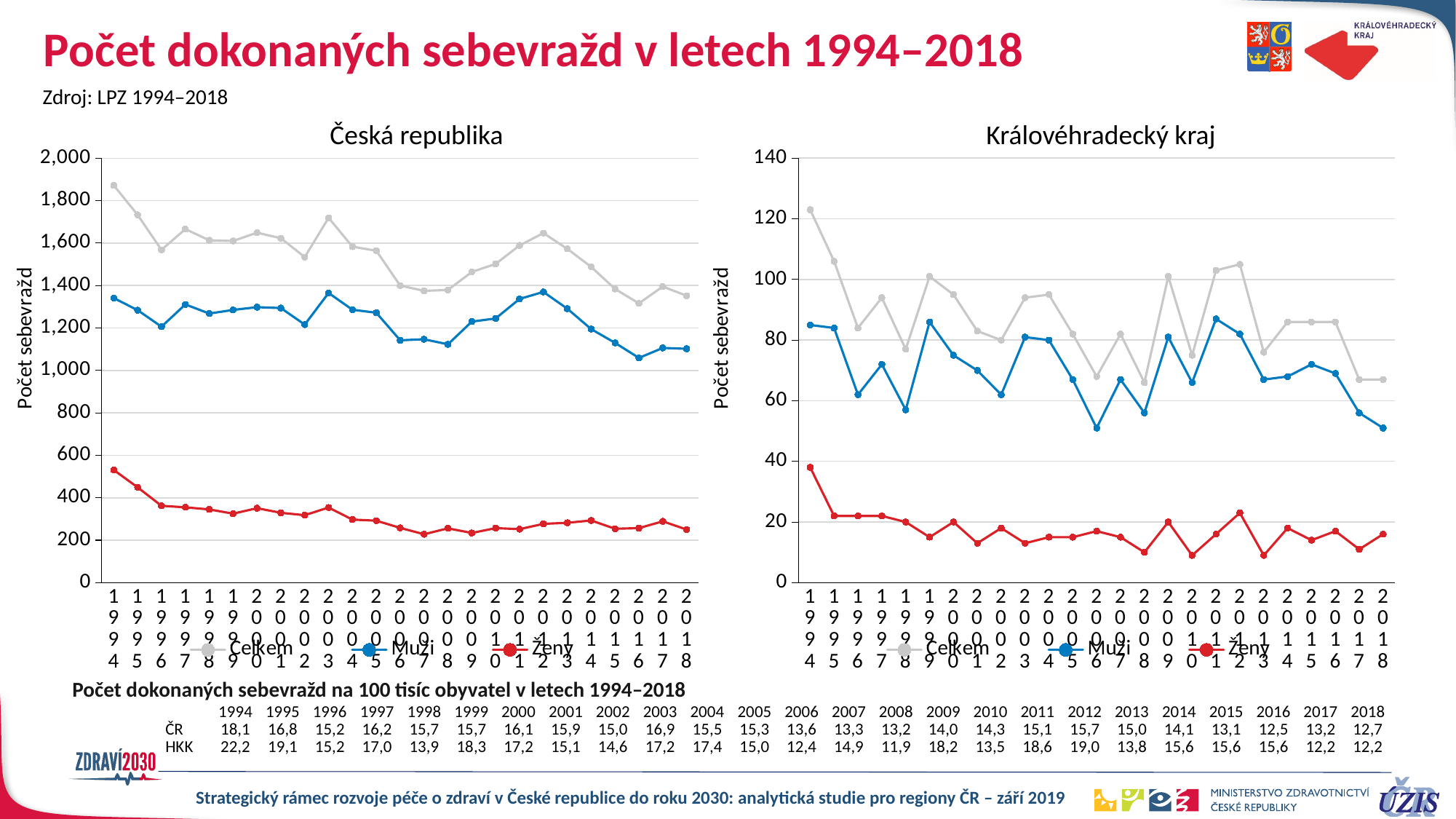
How many years are plotted along the x axis of the "Česká republika" chart? 25 In the "Česká republika" chart, which year has the highest Celkem value? 1994 How many series does the legend of the "Královéhradecký kraj" chart list? 3 In the "Královéhradecký kraj" chart, is the Celkem value for 1994 greater or less than 100? greater In the "Královéhradecký kraj" chart, is the Muži value for 2018 greater or less than 60? less In the "Česká republika" chart, which series has the larger value in 2018, Muži or Ženy? Muži In the "Královéhradecký kraj" chart, is the Ženy value for 1994 greater or less than 20? greater What kind of chart is the "Česká republika" chart? line chart In the "Česká republika" chart, does the Ženy series overall rise or fall from 1994 to 2018? fall